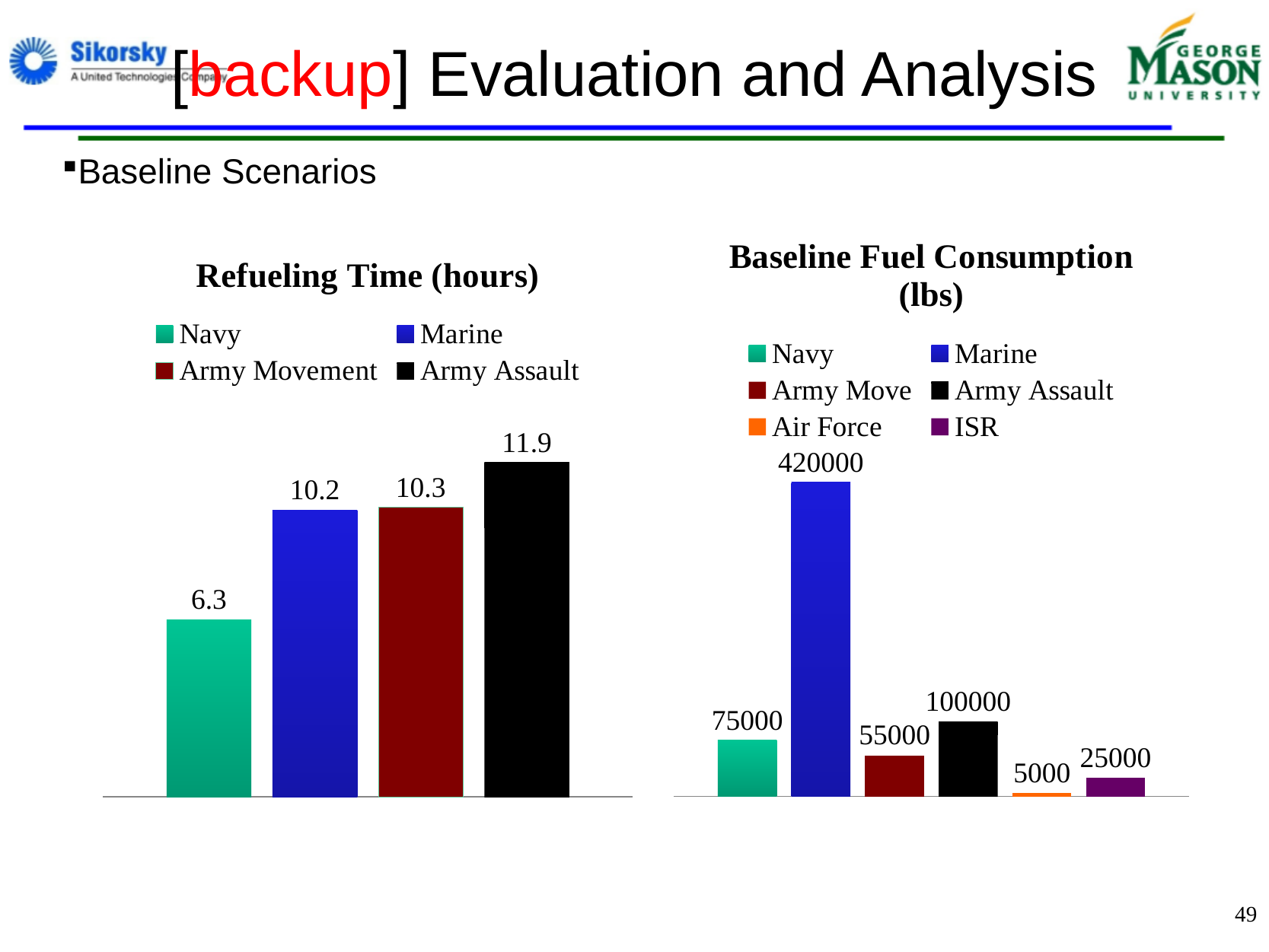
In the Baseline Fuel Consumption (lbs) chart, which is larger, Navy or Army Move? Navy In the Refueling Time (hours) chart, what is the value for Navy? 6.3 In the Baseline Fuel Consumption (lbs) chart, what is the difference between Army Assault and ISR? 75000 In the Baseline Fuel Consumption (lbs) chart, what is the value for Marine? 420000 In the Refueling Time (hours) chart, what is the value for Army Assault? 11.9 In the Refueling Time (hours) chart, what is the difference between Army Assault and Navy? 5.6 In the Baseline Fuel Consumption (lbs) chart, what is the value for Air Force? 5000 In the Baseline Fuel Consumption (lbs) chart, which series has the highest value? Marine In the Refueling Time (hours) chart, how many series does the legend list? 4 What kind of chart is the Baseline Fuel Consumption (lbs) chart? Bar chart In the Baseline Fuel Consumption (lbs) chart, how many series does the legend list? 6 In the Refueling Time (hours) chart, which series has the lowest value? Navy